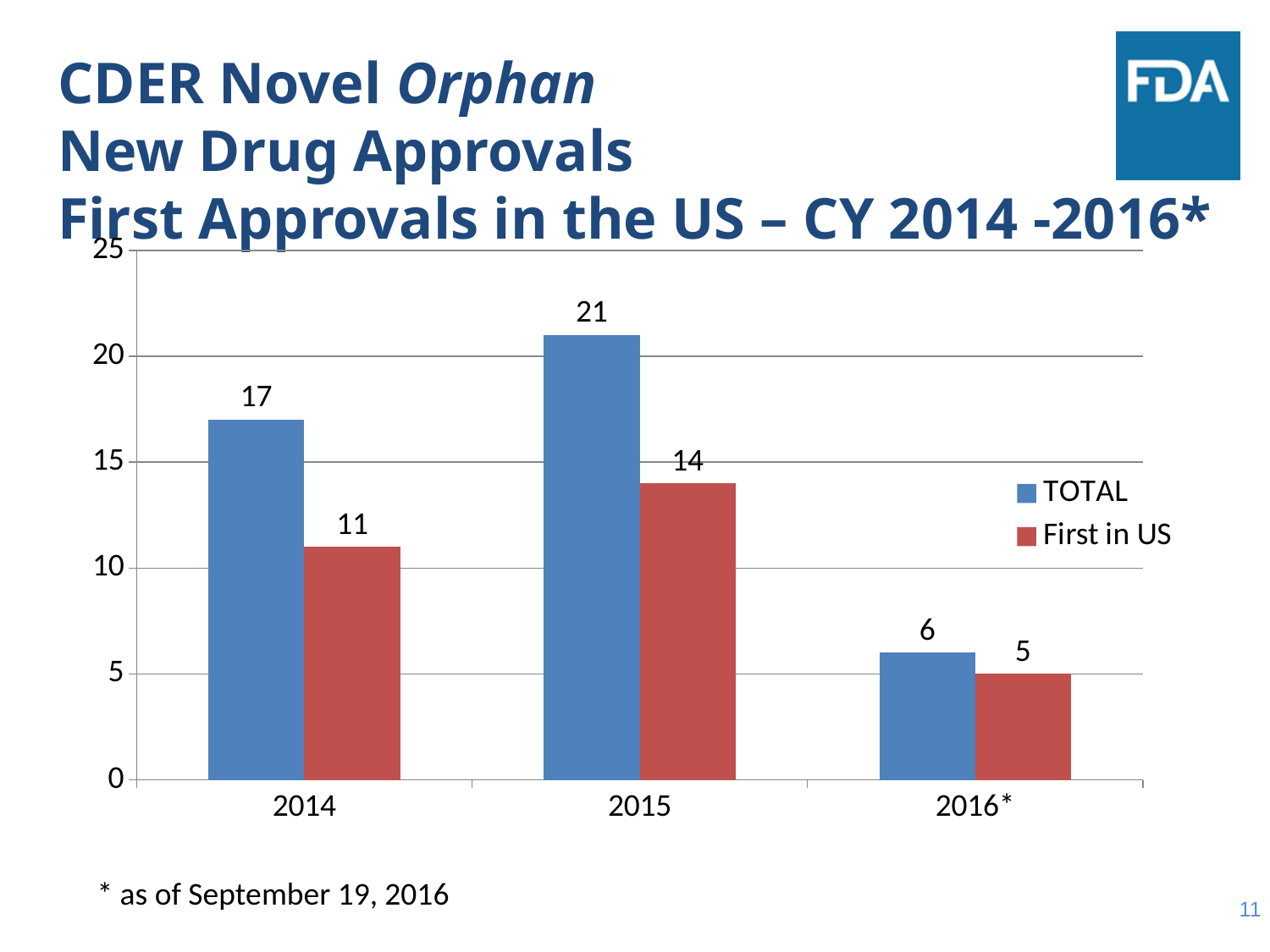
How many years are shown on the x axis? 3 What is the TOTAL value for 2016*? 6 What is the First in US value for 2014? 11 How many series does the legend list? 2 What kind of chart is shown on the slide? bar chart Which is larger: the TOTAL value for 2014 or the TOTAL value for 2015? 2015 What is the TOTAL value for 2014? 17 Which year has the highest TOTAL value? 2015 What is the First in US value for 2015? 14 Which year has the lowest First in US value? 2016* What colour represents the First in US series? red What is the difference between the TOTAL and First in US values for 2015? 7